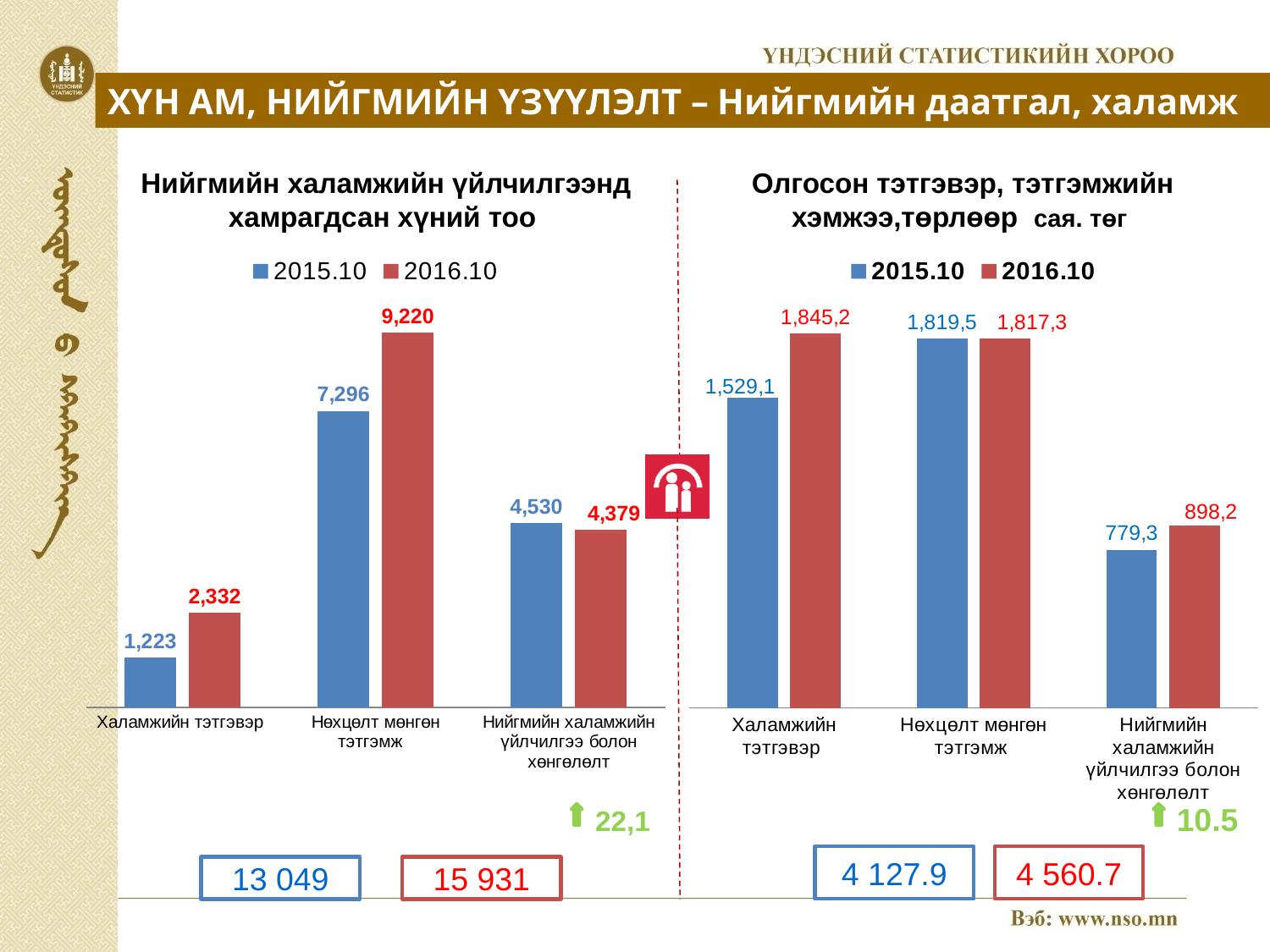
In the left chart (Нийгмийн халамжийн үйлчилгээнд хамрагдсан хүний тоо), which category has the highest 2016.10 value? Нөхцөлт мөнгөн тэтгэмж How many categories are shown on the x axis of the left chart (Нийгмийн халамжийн үйлчилгээнд хамрагдсан хүний тоо)? 3 In the right chart (Олгосон тэтгэвэр, тэтгэмжийн хэмжээ, төрлөөр), which category has the lowest 2016.10 value? Нийгмийн халамжийн үйлчилгээ болон хөнгөлөлт In the left chart (Нийгмийн халамжийн үйлчилгээнд хамрагдсан хүний тоо), what is the 2015.10 value for Халамжийн тэтгэвэр? 1,223 In the right chart (Олгосон тэтгэвэр, тэтгэмжийн хэмжээ, төрлөөр), what is the 2015.10 value for Нийгмийн халамжийн үйлчилгээ болон хөнгөлөлт? 779,3 In the left chart (Нийгмийн халамжийн үйлчилгээнд хамрагдсан хүний тоо), which category has the lowest 2015.10 value? Халамжийн тэтгэвэр In the right chart (Олгосон тэтгэвэр, тэтгэмжийн хэмжээ, төрлөөр), how many series does the legend list? 2 What type of chart is the right chart (Олгосон тэтгэвэр, тэтгэмжийн хэмжээ, төрлөөр)? Bar chart In the left chart (Нийгмийн халамжийн үйлчилгээнд хамрагдсан хүний тоо), what is the 2016.10 value for Нөхцөлт мөнгөн тэтгэмж? 9,220 In the right chart (Олгосон тэтгэвэр, тэтгэмжийн хэмжээ, төрлөөр), what is the 2016.10 value for Халамжийн тэтгэвэр? 1,845,2 In the left chart (Нийгмийн халамжийн үйлчилгээнд хамрагдсан хүний тоо), what is the difference between the 2016.10 and 2015.10 values for Нөхцөлт мөнгөн тэтгэмж? 1,924 In the left chart (Нийгмийн халамжийн үйлчилгээнд хамрагдсан хүний тоо), for Нийгмийн халамжийн үйлчилгээ болон хөнгөлөлт, which is larger: the 2015.10 value or the 2016.10 value? 2015.10